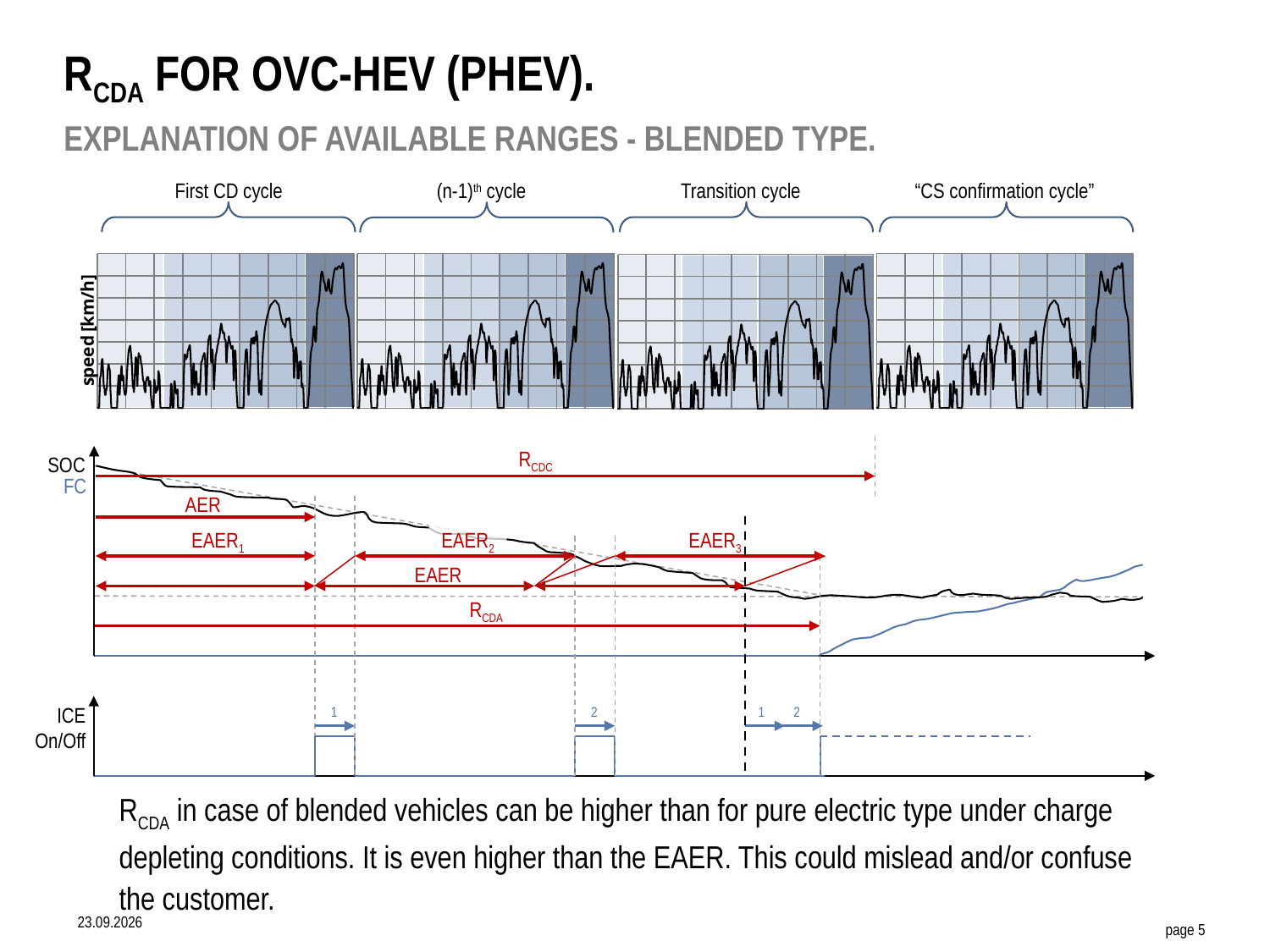
In the SOC/FC panel, does the blue FC line rise or fall along the x axis during the CS confirmation cycle? rise In the SOC/FC panel, which range arrow is longer, R_CDA or AER? R_CDA How many driving cycles are shown across the top speed panel? 4 In the SOC/FC panel, which range arrow is longer, R_CDA or EAER? R_CDA What kind of chart is the speed panel at the top of the slide? line chart In the SOC/FC panel, does the black SOC line rise or fall along the x axis before the CS confirmation cycle? fall In the SOC/FC panel, which of the labelled range arrows is the longest? R_CDC What is the label of the first cycle shown at the top of the slide? First CD cycle What is the label of the last cycle shown at the top of the slide? "CS confirmation cycle" What is the y-axis label of the top speed panel? speed [km/h] How many ICE On pulses are shown in the ICE On/Off panel before the ICE stays on continuously? 2 In the SOC/FC panel, which range arrow is longer, R_CDC or R_CDA? R_CDC